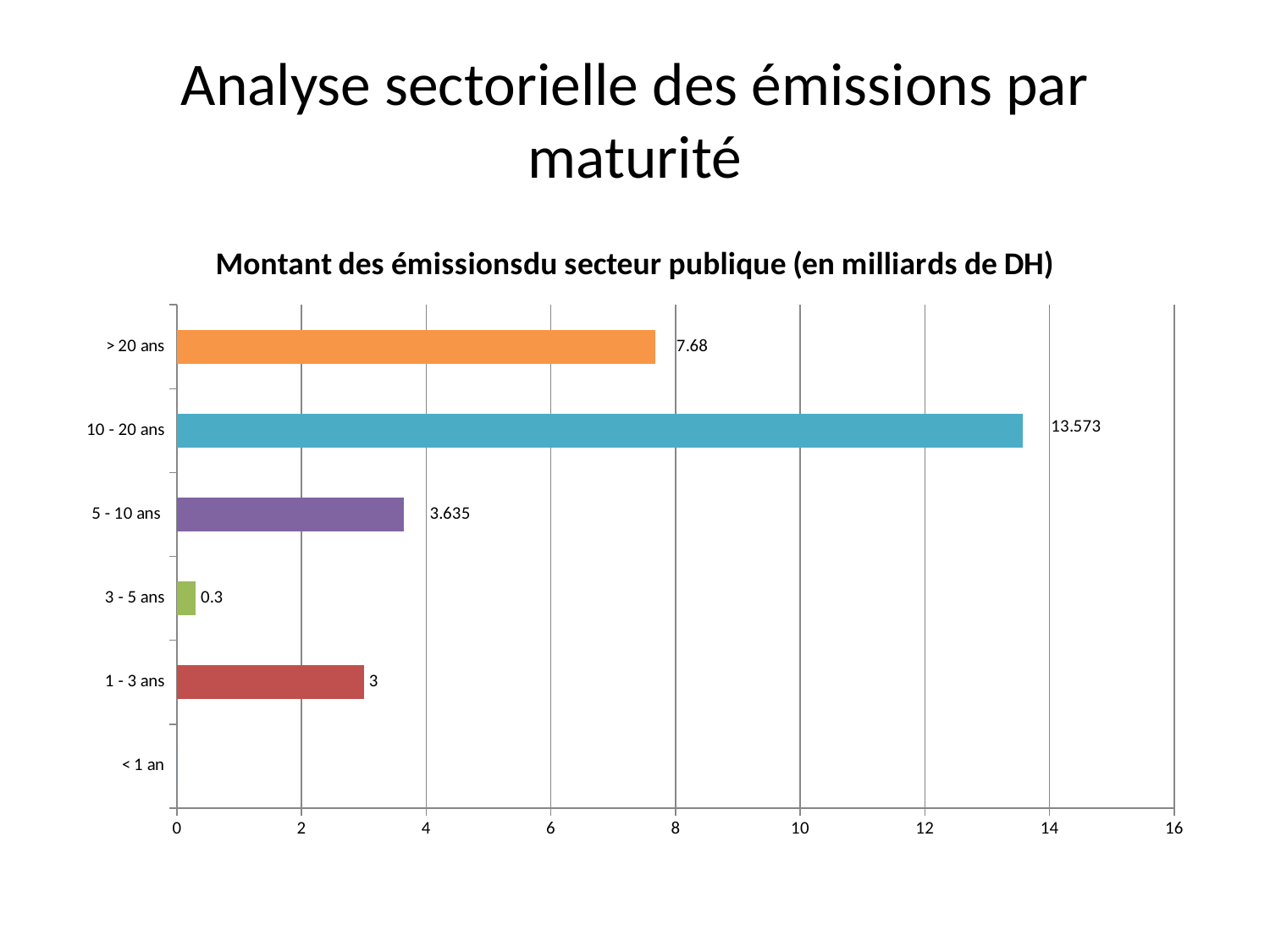
How many maturity categories are shown on the y axis? 6 What is the difference between the values for 10 - 20 ans and > 20 ans? 5.893 What is the value for the 10 - 20 ans category? 13.573 What kind of chart is shown on the slide? bar chart What is the value for the 5 - 10 ans category? 3.635 Is the value for > 20 ans greater or less than 8? less What is the title of the chart? Montant des émissionsdu secteur publique (en milliards de DH) What is the value for the > 20 ans category? 7.68 Which maturity category with a visible bar has the lowest value? 3 - 5 ans Which maturity category has the highest value? 10 - 20 ans What is the value for the 3 - 5 ans category? 0.3 Which is larger, the value for 5 - 10 ans or the value for 1 - 3 ans? 5 - 10 ans